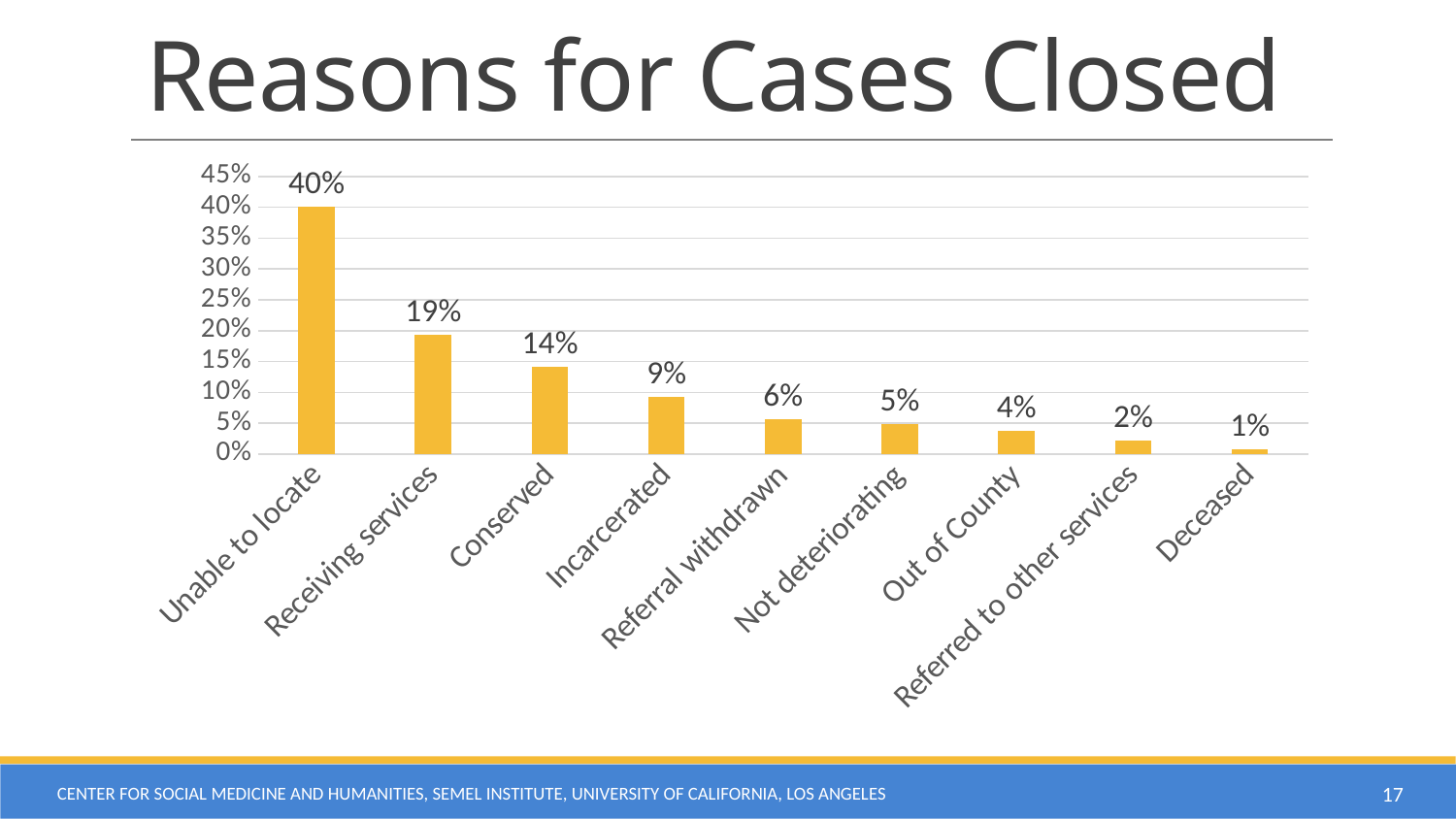
Which reason for case closure has the highest percentage? Unable to locate How many reasons for cases closed are shown on the chart? 9 Do the values rise or fall from left to right along the x axis? Fall What is the difference between the values for Incarcerated and Out of County? 5% What is the difference between the values for Unable to locate and Receiving services? 21% What is the value for Referred to other services? 2% What is the value for Referral withdrawn? 6% What percentage of cases were closed because the client was unable to be located? 40% What is the value for Conserved? 14% Which is larger, the value for Not deteriorating or the value for Referral withdrawn? Referral withdrawn Which reason for case closure has the lowest percentage? Deceased What kind of chart is shown on the slide? Bar chart